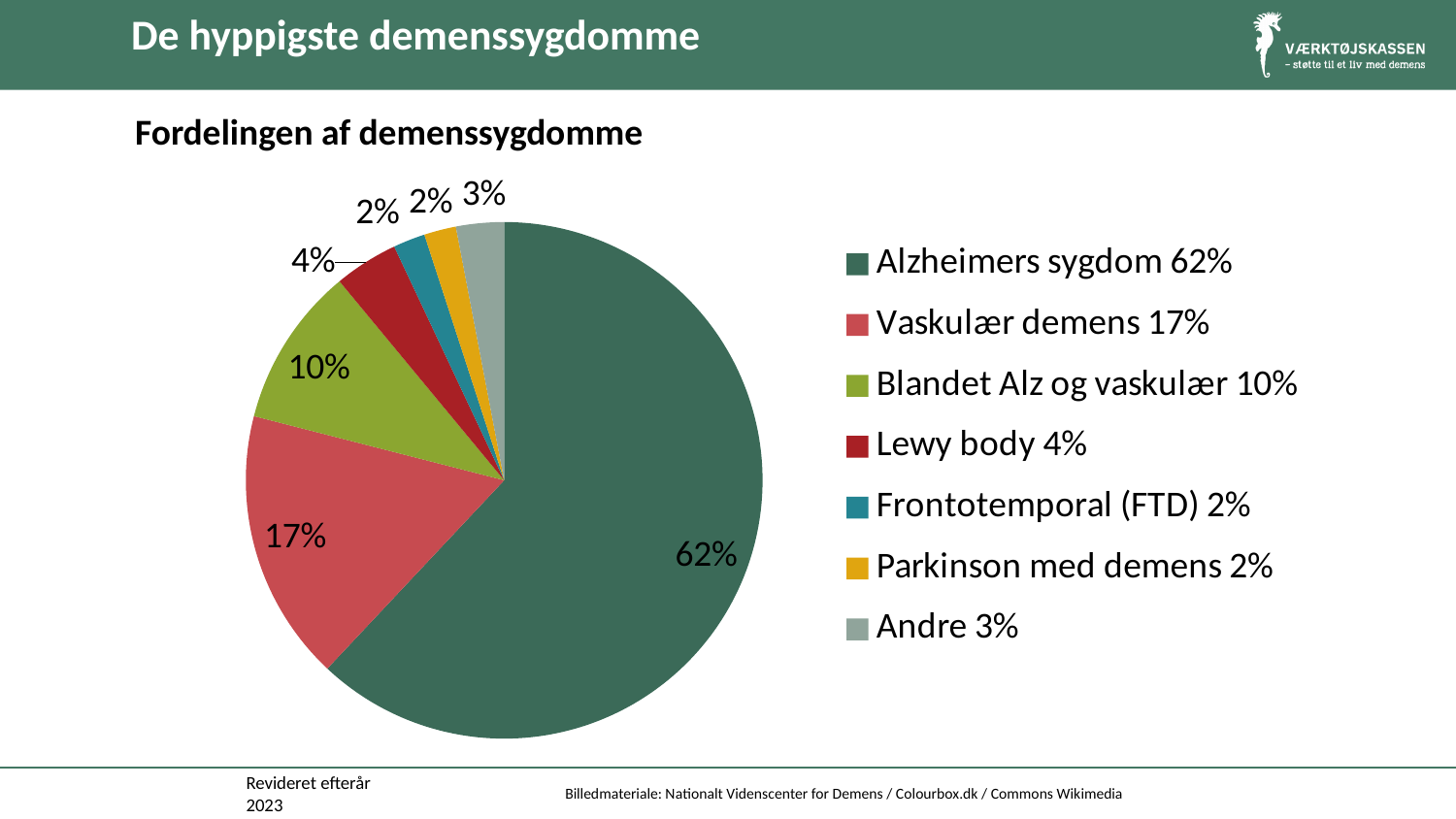
What share of the pie does Alzheimers sygdom account for? 62% What is the combined value of Frontotemporal (FTD) and Parkinson med demens? 4% What is the value for Lewy body? 4% What is the value for Vaskulær demens? 17% What is the title of the chart? Fordelingen af demenssygdomme What is the difference between the values for Alzheimers sygdom and Vaskulær demens? 45% Which is larger, the value for Lewy body or the value for Andre? Lewy body How many slices does the pie chart have? 7 What is the value for Andre? 3% Which category has the largest slice of the pie? Alzheimers sygdom What kind of chart is shown on the slide? pie chart What is the value for Blandet Alz og vaskulær? 10%